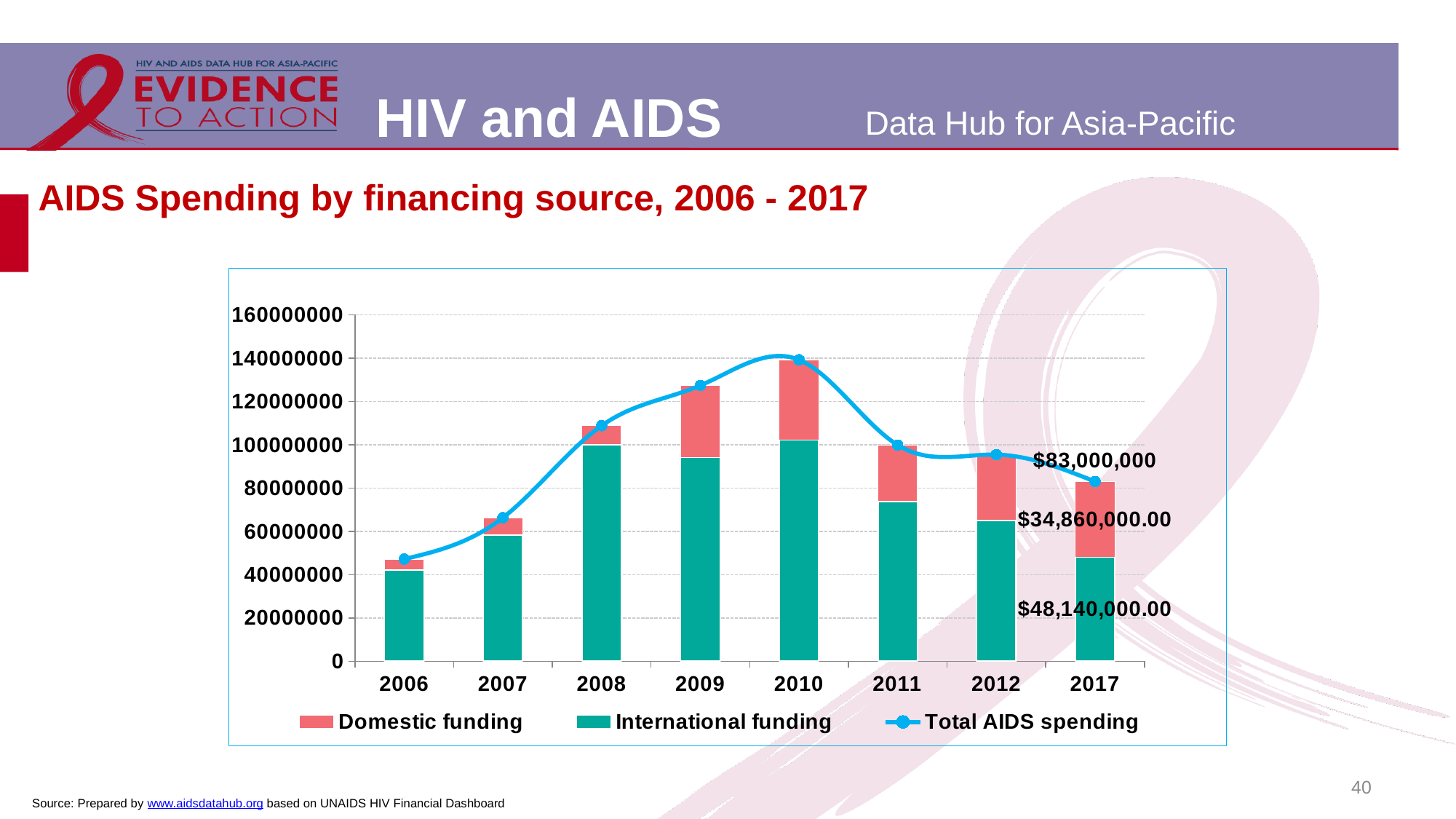
Does Total AIDS spending rise or fall from 2010 to 2017? Fall Which year has the lowest Total AIDS spending? 2006 Which year has the highest Total AIDS spending? 2010 What is the Domestic funding value labelled for 2017? $34,860,000.00 How many years are shown on the x axis of the chart? 8 In 2017, which is larger: Domestic funding or International funding? International funding What is the Total AIDS spending value labelled for 2017? $83,000,000 What is the International funding value labelled for 2017? $48,140,000.00 Is the Total AIDS spending for 2010 greater or less than 120000000? greater How many series does the chart legend list? 3 What is the difference between International funding and Domestic funding in 2017? $13,280,000.00 What type of chart is shown on the slide? Stacked bar chart with a line